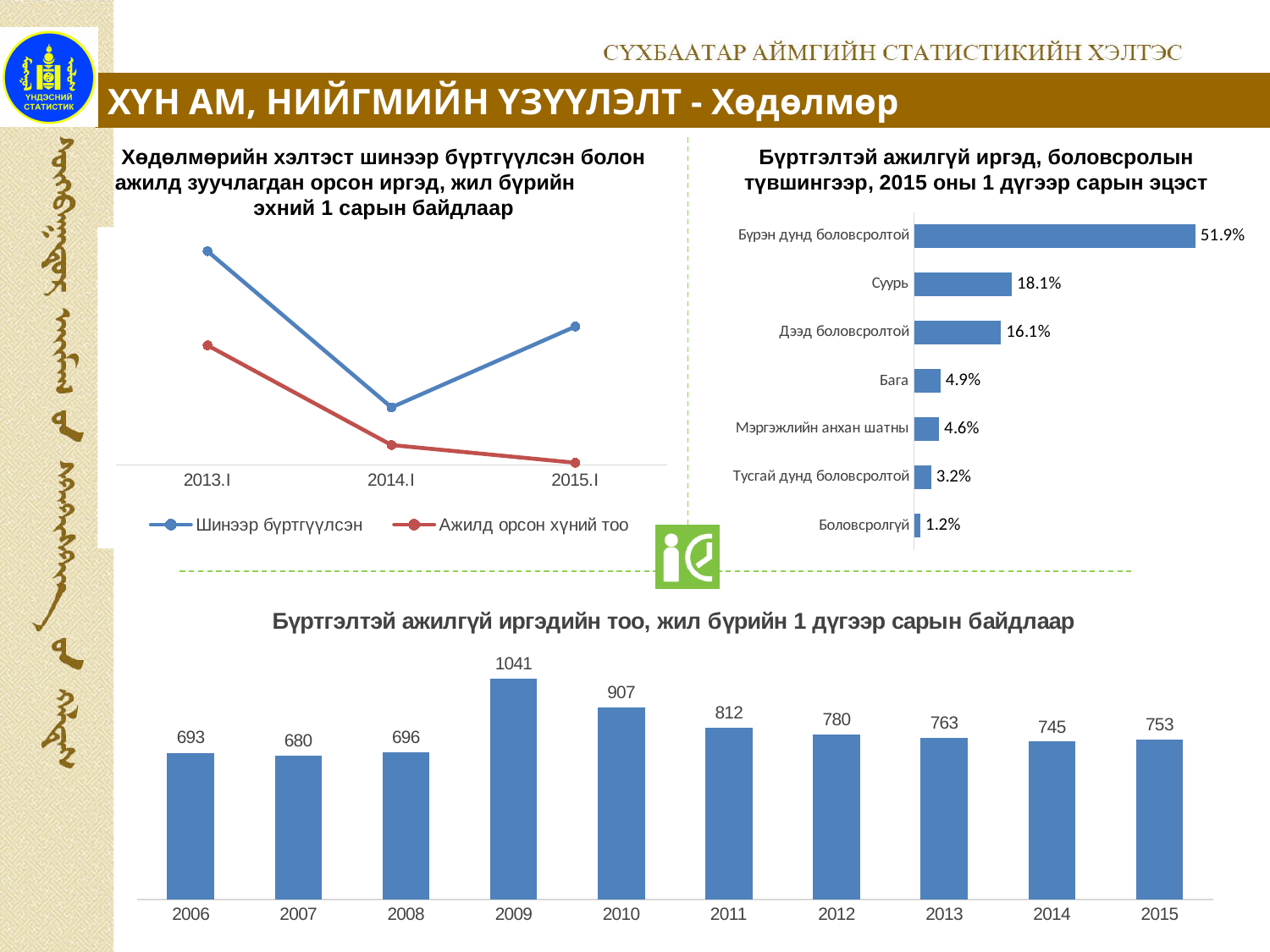
In the bottom chart 'Бүртгэлтэй ажилгүй иргэдийн тоо, жил бүрийн 1 дүгээр сарын байдлаар', do the values rise or fall from 2009 to 2014? fall In the top-left line chart, which series has the higher value at 2013.I, 'Шинээр бүртгүүлсэн' or 'Ажилд орсон хүний тоо'? Шинээр бүртгүүлсэн In the bottom chart 'Бүртгэлтэй ажилгүй иргэдийн тоо, жил бүрийн 1 дүгээр сарын байдлаар', what is the value for 2009? 1041 In the bottom chart 'Бүртгэлтэй ажилгүй иргэдийн тоо, жил бүрийн 1 дүгээр сарын байдлаар', which year has the lowest value? 2007 In the bottom chart 'Бүртгэлтэй ажилгүй иргэдийн тоо, жил бүрийн 1 дүгээр сарын байдлаар', which year has the highest value? 2009 In the top-left line chart, how many series does the legend list? 2 In the top-right chart 'Бүртгэлтэй ажилгүй иргэд, боловсролын түвшингээр, 2015 оны 1 дүгээр сарын эцэст', what is the value for 'Дээд боловсролтой'? 16.1% In the bottom chart 'Бүртгэлтэй ажилгүй иргэдийн тоо, жил бүрийн 1 дүгээр сарын байдлаар', how many years are shown? 10 In the bottom chart 'Бүртгэлтэй ажилгүй иргэдийн тоо, жил бүрийн 1 дүгээр сарын байдлаар', what is the difference between the values for 2009 and 2010? 134 In the top-right chart 'Бүртгэлтэй ажилгүй иргэд, боловсролын түвшингээр, 2015 оны 1 дүгээр сарын эцэст', which category has the highest value? Бүрэн дунд боловсролтой In the top-right chart 'Бүртгэлтэй ажилгүй иргэд, боловсролын түвшингээр, 2015 оны 1 дүгээр сарын эцэст', what is the difference between 'Суурь' and 'Бага'? 13.2% In the top-right chart 'Бүртгэлтэй ажилгүй иргэд, боловсролын түвшингээр, 2015 оны 1 дүгээр сарын эцэст', how many categories are shown? 7